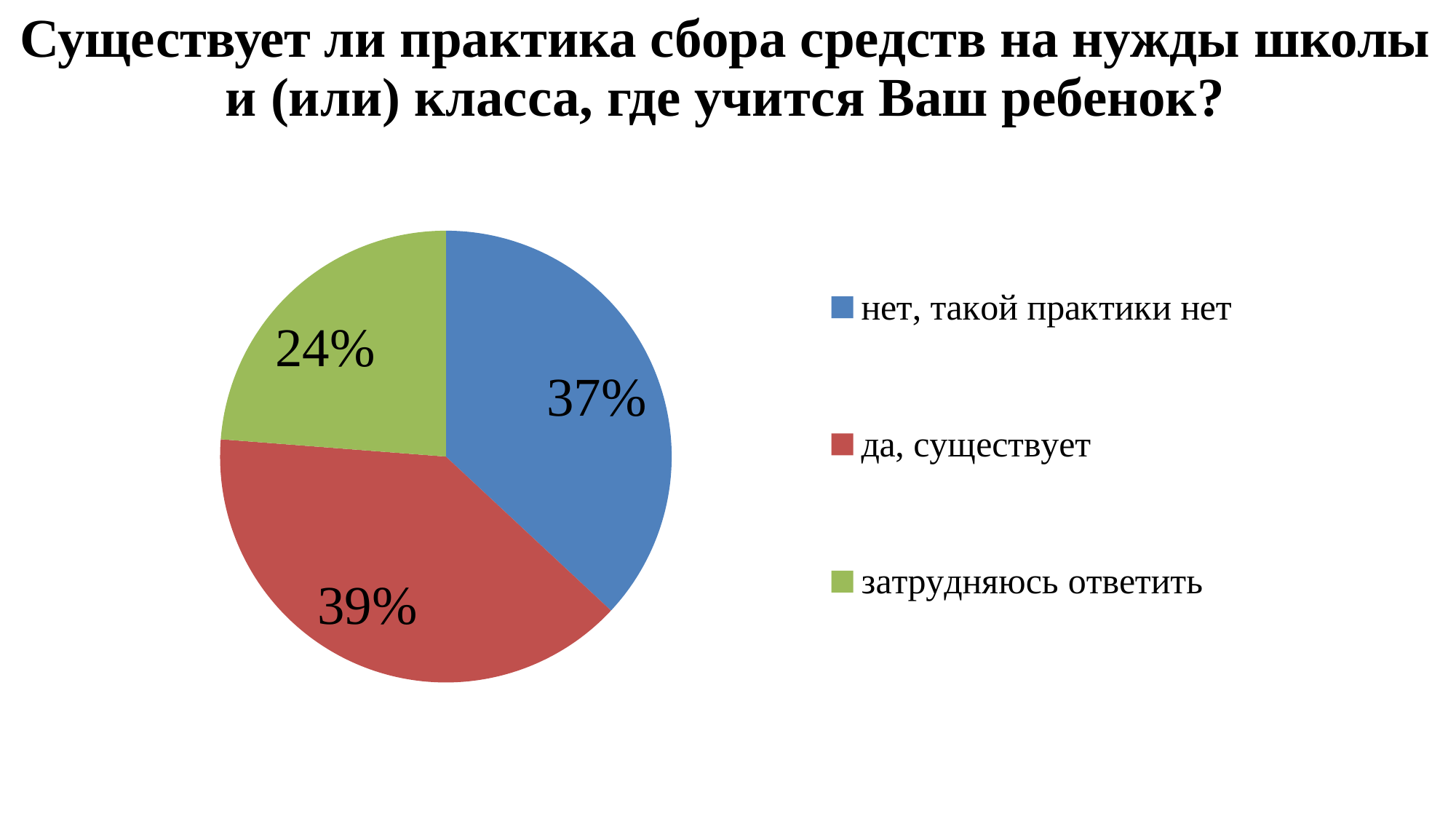
What type of chart is shown on the slide? pie chart Which category has the smallest slice of the pie? затрудняюсь ответить Which category has the largest slice of the pie? да, существует What is the difference in percentage points between "да, существует" and "нет, такой практики нет"? 2% How many slices does the pie chart have? 3 Which colour represents "затрудняюсь ответить" in the legend? green What share of the pie does "нет, такой практики нет" have? 37% Which colour represents "нет, такой практики нет" in the legend? blue What is the difference in percentage points between "нет, такой практики нет" and "затрудняюсь ответить"? 13% Which is larger: the slice for "да, существует" or the slice for "затрудняюсь ответить"? да, существует What share of the pie does "затрудняюсь ответить" have? 24% What share of the pie does "да, существует" have? 39%